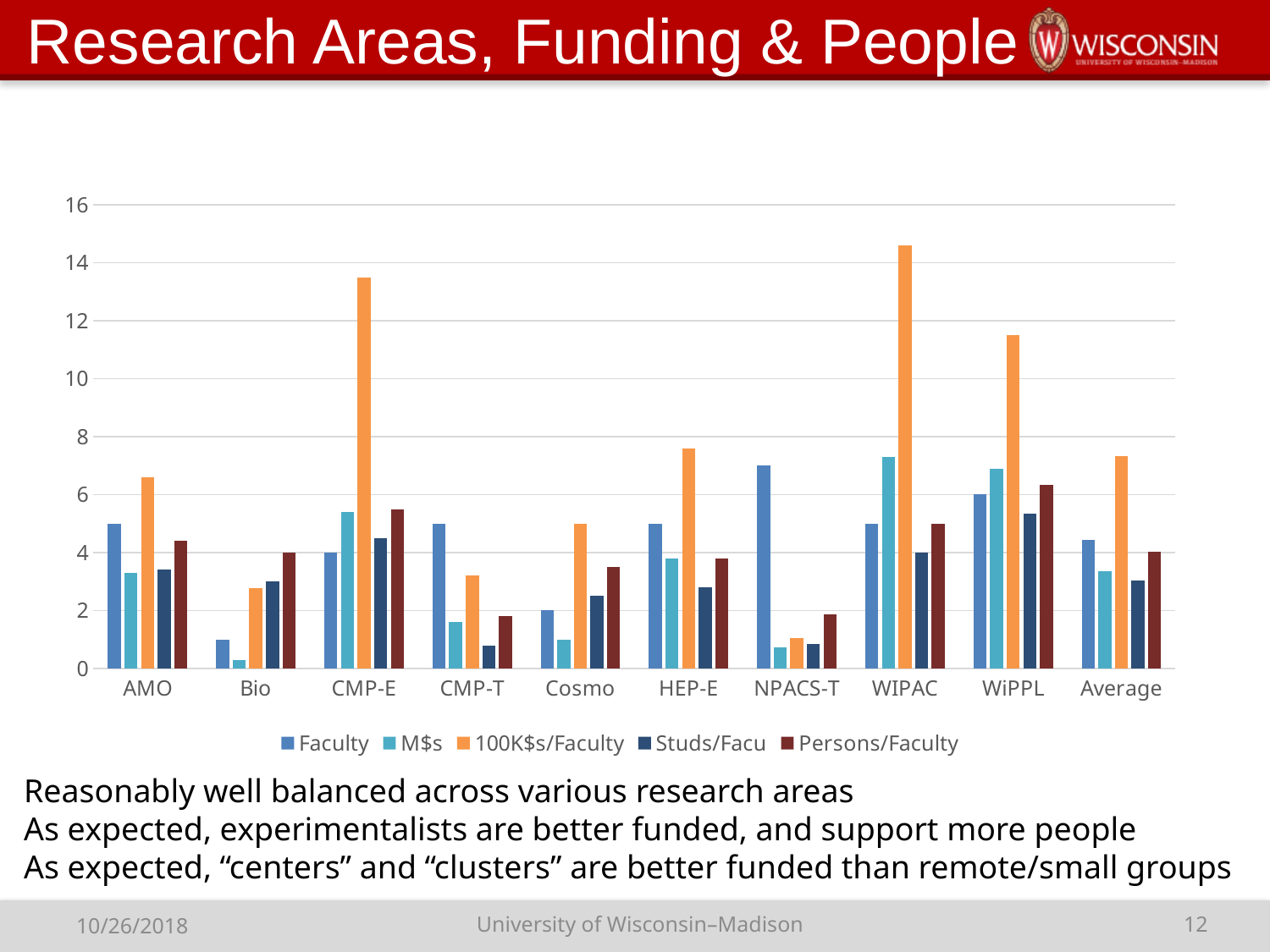
Which is larger, the Faculty value for NPACS-T or for WIPAC? NPACS-T What colour represents the 100K$s/Faculty series in the legend? orange Is the Faculty value for NPACS-T greater or less than 6? greater Which category has the highest 100K$s/Faculty value? WIPAC How many series does the legend list? 5 Which is larger, the 100K$s/Faculty value for HEP-E or for Cosmo? HEP-E Is the M$s value for WIPAC greater or less than 6? greater How many research-area categories are shown along the x axis? 10 Which category has the highest Faculty value? NPACS-T Which category has the lowest M$s value? Bio Is the 100K$s/Faculty value for CMP-E greater or less than 12? greater What kind of chart is shown on the slide? bar chart